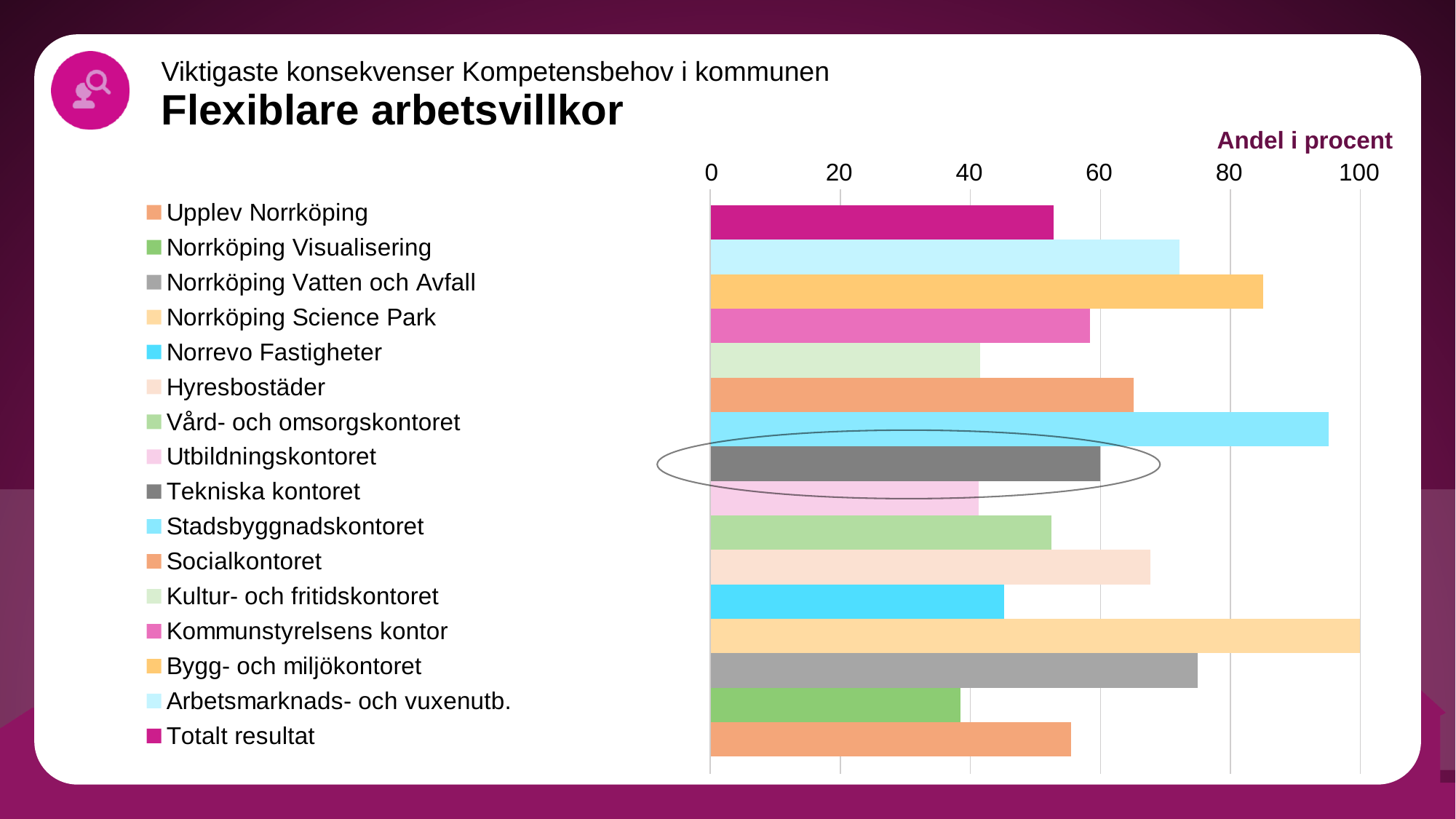
How many bars are plotted in the chart? 16 How many series does the legend list? 16 Is the value for Norrevo Fastigheter greater or less than 60? less Is the value for Kultur- och fritidskontoret greater or less than 60? less What kind of chart is shown on the slide? bar chart Which series' bar is circled in the chart? Tekniska kontoret Is the value for Stadsbyggnadskontoret greater or less than 80? greater What is the label shown above the horizontal axis of the chart? Andel i procent Which is larger, the value for Bygg- och miljökontoret or the value for Kommunstyrelsens kontor? Bygg- och miljökontoret Which series has the highest value in the chart? Norrköping Science Park Which is larger, the value for Stadsbyggnadskontoret or the value for Socialkontoret? Stadsbyggnadskontoret